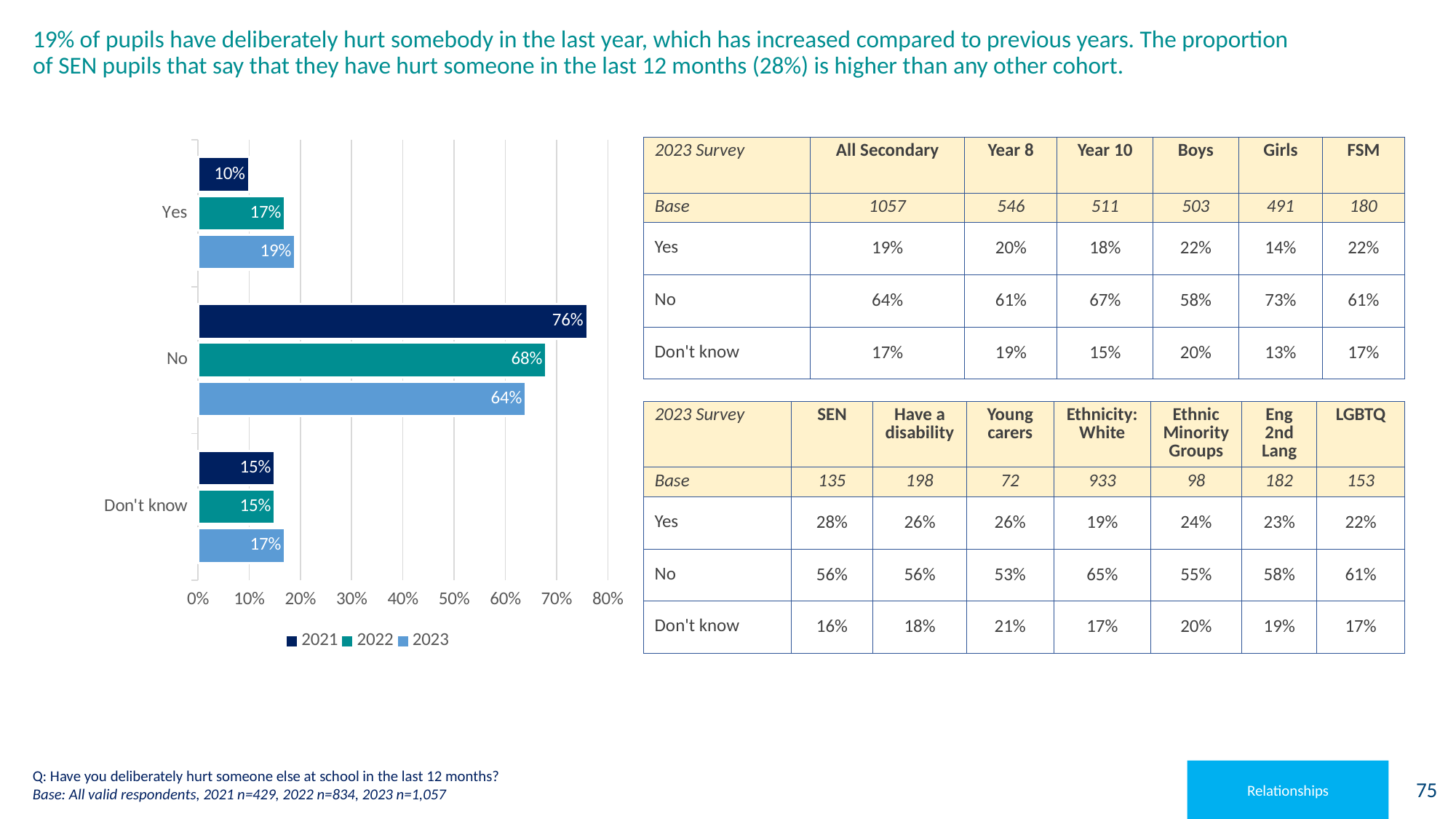
What is the difference between the 'No' values for 2021 and 2023? 12% What is the value for 'No' in 2021? 76% Which category has the highest value in 2023? No What is the value for 'Don't know' in 2022? 15% Which series is shown in the darkest colour in the legend? 2021 Which is larger, the 'Yes' value for 2022 or the 'Yes' value for 2023? 2023 Which category has the lowest value in 2021? Yes How many series does the legend list? 3 What is the value for 'Yes' in 2023? 19% What kind of chart is shown on the slide? bar chart How many categories are shown on the chart? 3 Is the value for 'No' in 2022 greater or less than 60%? greater